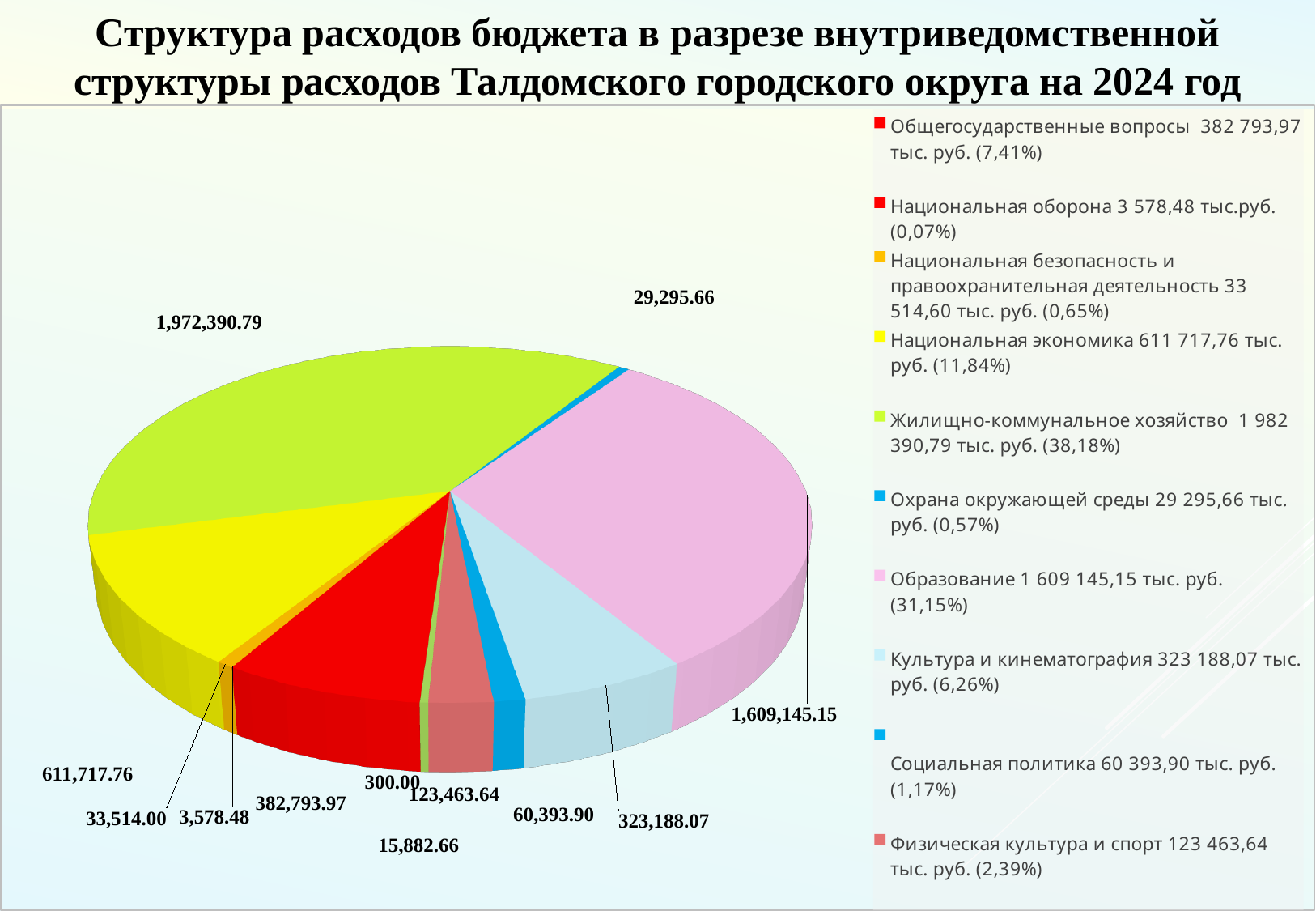
Which is larger, the slice for Национальная экономика or the slice for Общегосударственные вопросы? Национальная экономика Which category has the largest slice of the pie? Жилищно-коммунальное хозяйство What is the data label on the Социальная политика slice? 60,393.90 How many entries does the legend list? 10 What is the difference between the data labels for Образование and Культура и кинематография? 1,285,957.08 What is the smallest data label value printed on the pie chart? 300.00 According to the legend, what share of the budget does Национальная экономика account for? 11,84% According to the legend, what share of the budget does Образование account for? 31,15% What is the data label on the Охрана окружающей среды slice? 29,295.66 What is the data label on the Образование slice? 1,609,145.15 What kind of chart is shown on the slide? pie chart What is the difference between the data labels for Национальная экономика and Общегосударственные вопросы? 228,923.79